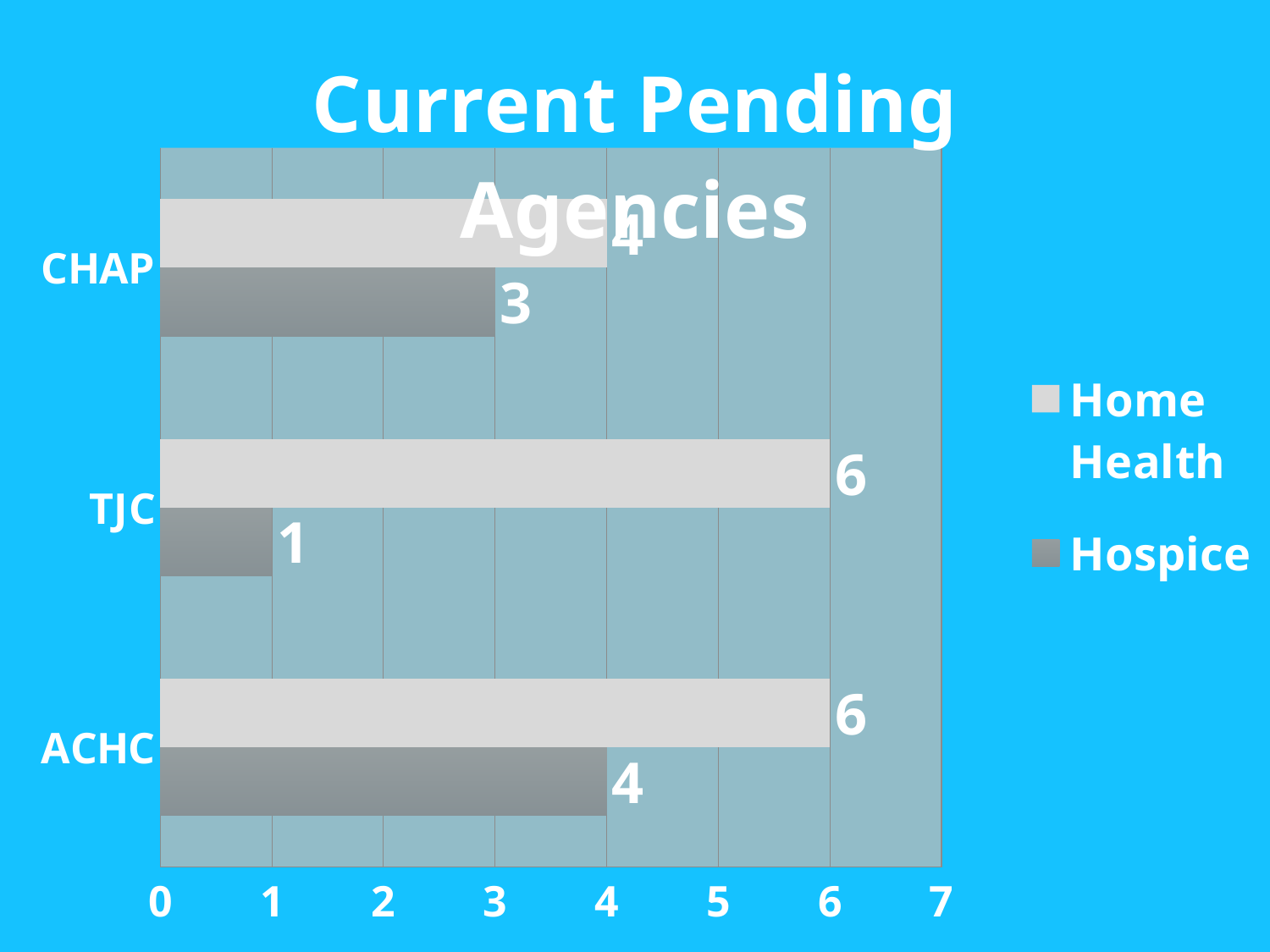
Is the Hospice value for CHAP larger or smaller than the Hospice value for ACHC? smaller What is the Hospice value for ACHC? 4 How many categories are shown on the chart? 3 What is the difference between the Home Health and Hospice values for TJC? 5 What is the Home Health value for CHAP? 4 Which category has the lowest Home Health value? CHAP What kind of chart is shown on the slide? bar chart What is the Home Health value for TJC? 6 Which category has the highest Hospice value? ACHC How many series does the legend list? 2 Which category has the lowest Hospice value? TJC What is the Hospice value for TJC? 1